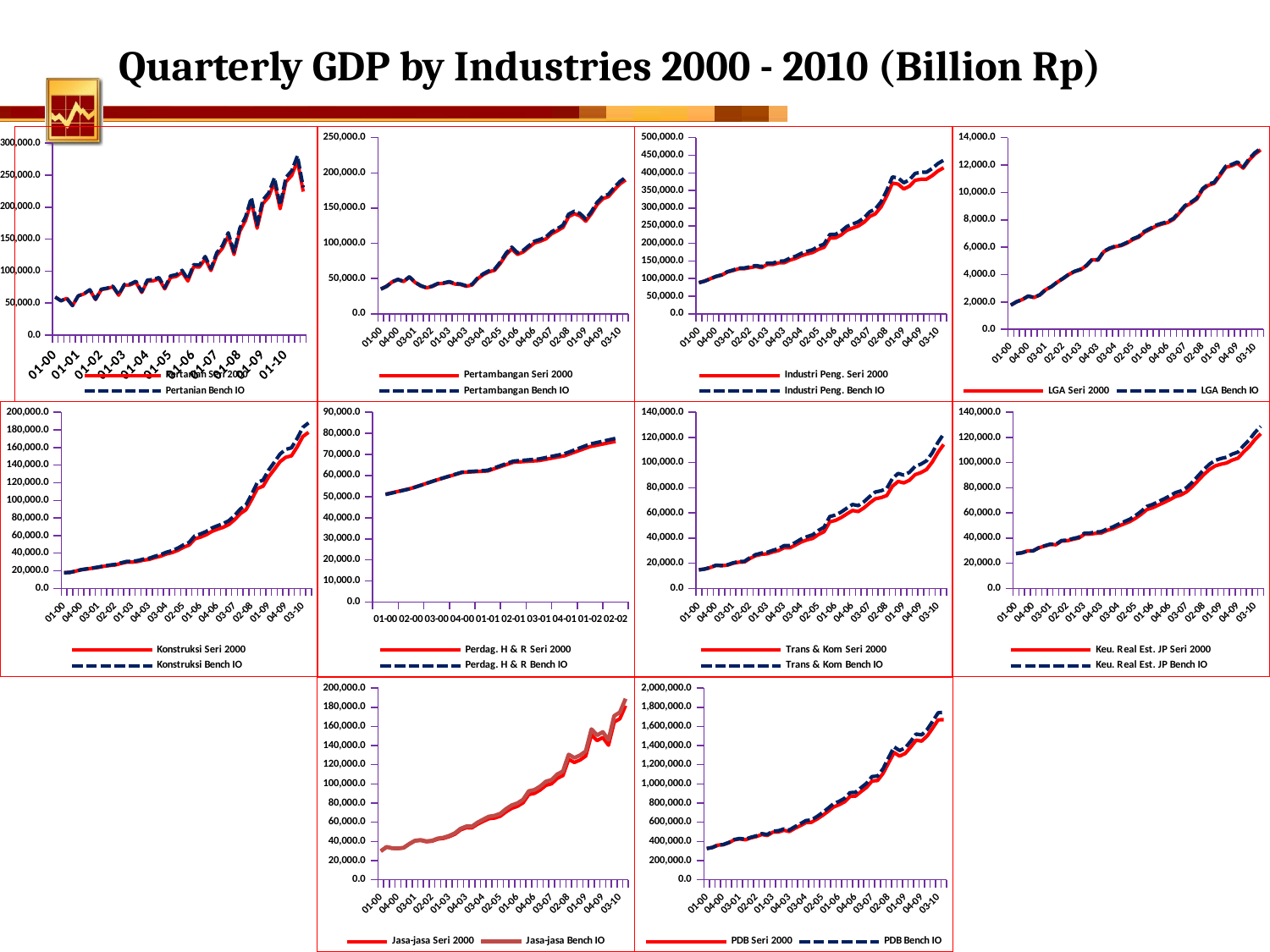
In the LGA chart, is the value for LGA Seri 2000 at 03-10 greater or less than 10,000.0? greater What is the title of the slide? Quarterly GDP by Industries 2000 - 2010 (Billion Rp) In the Trans & Kom chart, is the value for Trans & Kom Seri 2000 at 03-10 greater or less than 100,000.0? greater What kind of chart is the Pertambangan chart? line chart In the Perdag. H & R chart, do the values rise or fall along the x axis? rise In the Konstruksi chart, is the value for Konstruksi Seri 2000 at 01-00 greater or less than 40,000.0? less How many series does the legend of the Konstruksi chart list? 2 What are the two legend entries of the Jasa-jasa chart? Jasa-jasa Seri 2000 and Jasa-jasa Bench IO In the PDB chart, do the values rise or fall from 01-00 to 03-10? rise